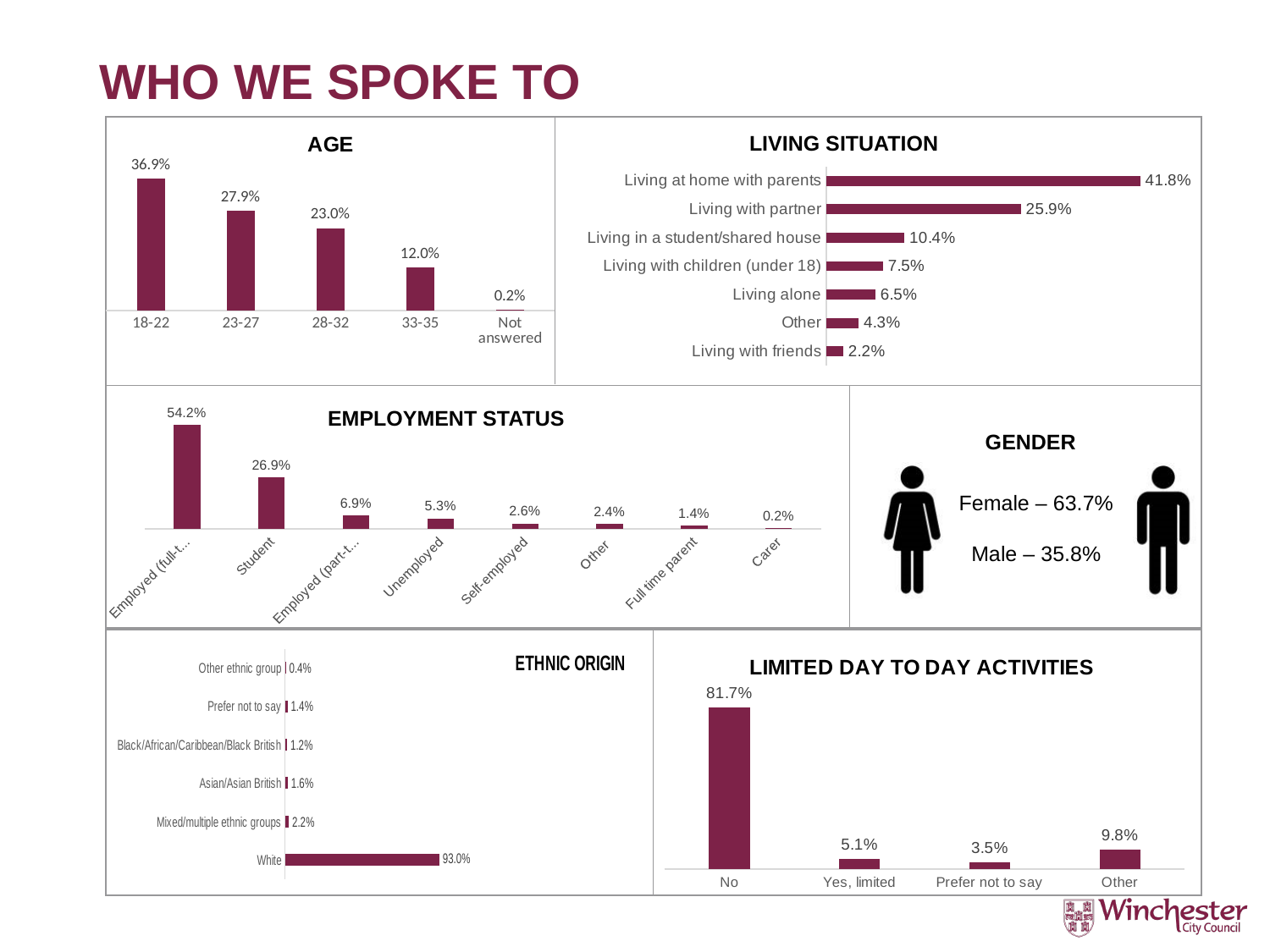
In the LIMITED DAY TO DAY ACTIVITIES chart, what is the value for Yes, limited? 5.1% In the LIVING SITUATION chart, which category has the highest value? Living at home with parents In the LIVING SITUATION chart, how many categories are shown? 7 In the ETHNIC ORIGIN chart, what is the difference between Mixed/multiple ethnic groups and Asian/Asian British? 0.6% In the ETHNIC ORIGIN chart, what is the value for White? 93.0% In the LIVING SITUATION chart, what is the difference between Living alone and Living with friends? 4.3% In the LIVING SITUATION chart, what is the value for Living with partner? 25.9% In the EMPLOYMENT STATUS chart, which is larger, Unemployed or Self-employed? Unemployed In the EMPLOYMENT STATUS chart, what is the value for Student? 26.9% In the AGE chart, which age group has the lowest value? Not answered What kind of chart is the LIMITED DAY TO DAY ACTIVITIES chart? Bar chart In the AGE chart, what percentage of respondents were aged 18-22? 36.9%